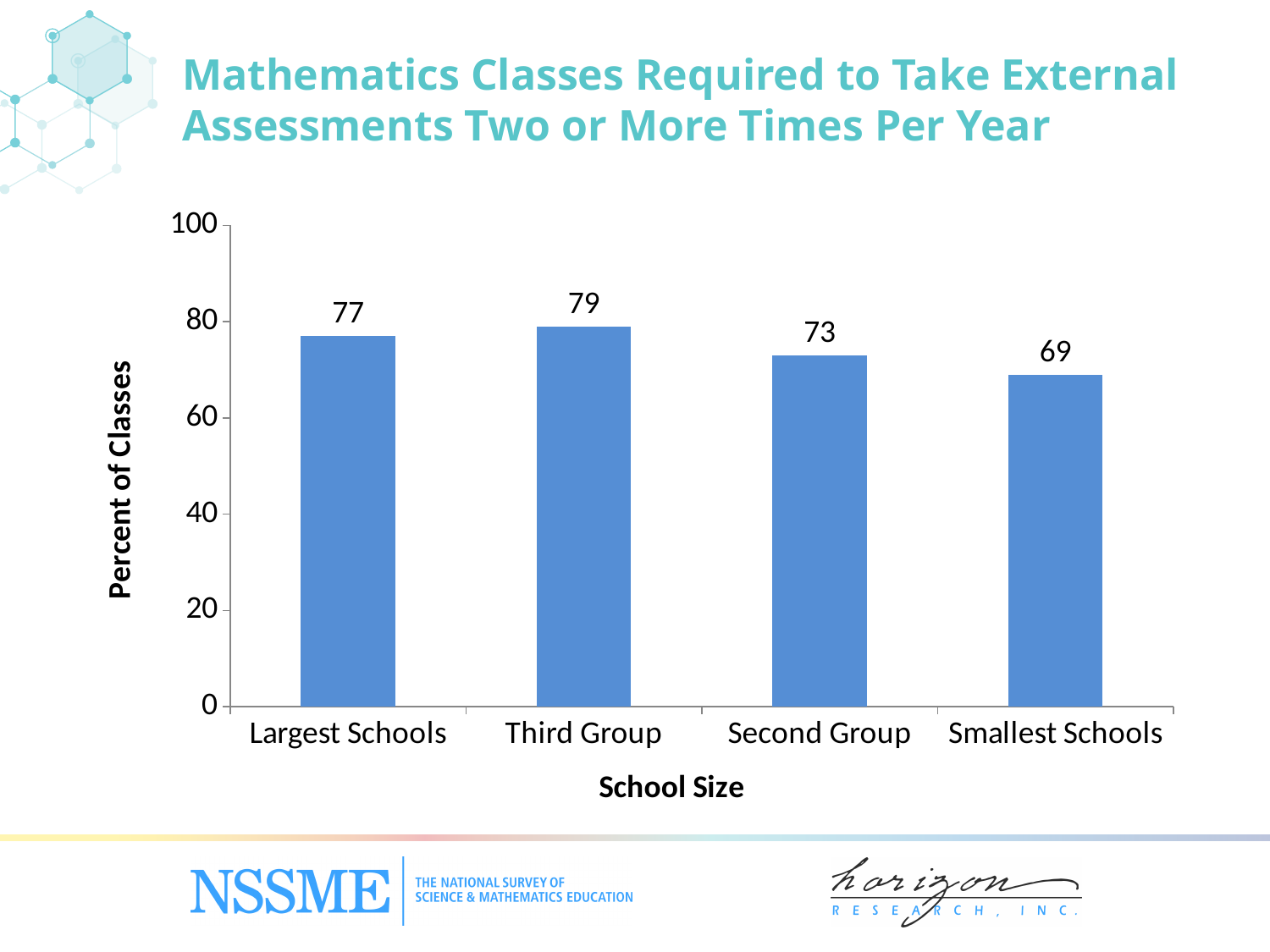
What kind of chart is shown on the slide? Bar chart What is the difference between the values for Largest Schools and Second Group? 4 What is the label of the y axis? Percent of Classes What percent of classes is shown for Third Group? 79 Which school size category has the highest percent of classes? Third Group How many school size categories are shown on the x axis? 4 What percent of classes is shown for Second Group? 73 Which is larger, the value for Largest Schools or the value for Second Group? Largest Schools What percent of classes is shown for Largest Schools? 77 What percent of classes is shown for Smallest Schools? 69 What is the difference between the values for Third Group and Smallest Schools? 10 Which school size category has the lowest percent of classes? Smallest Schools